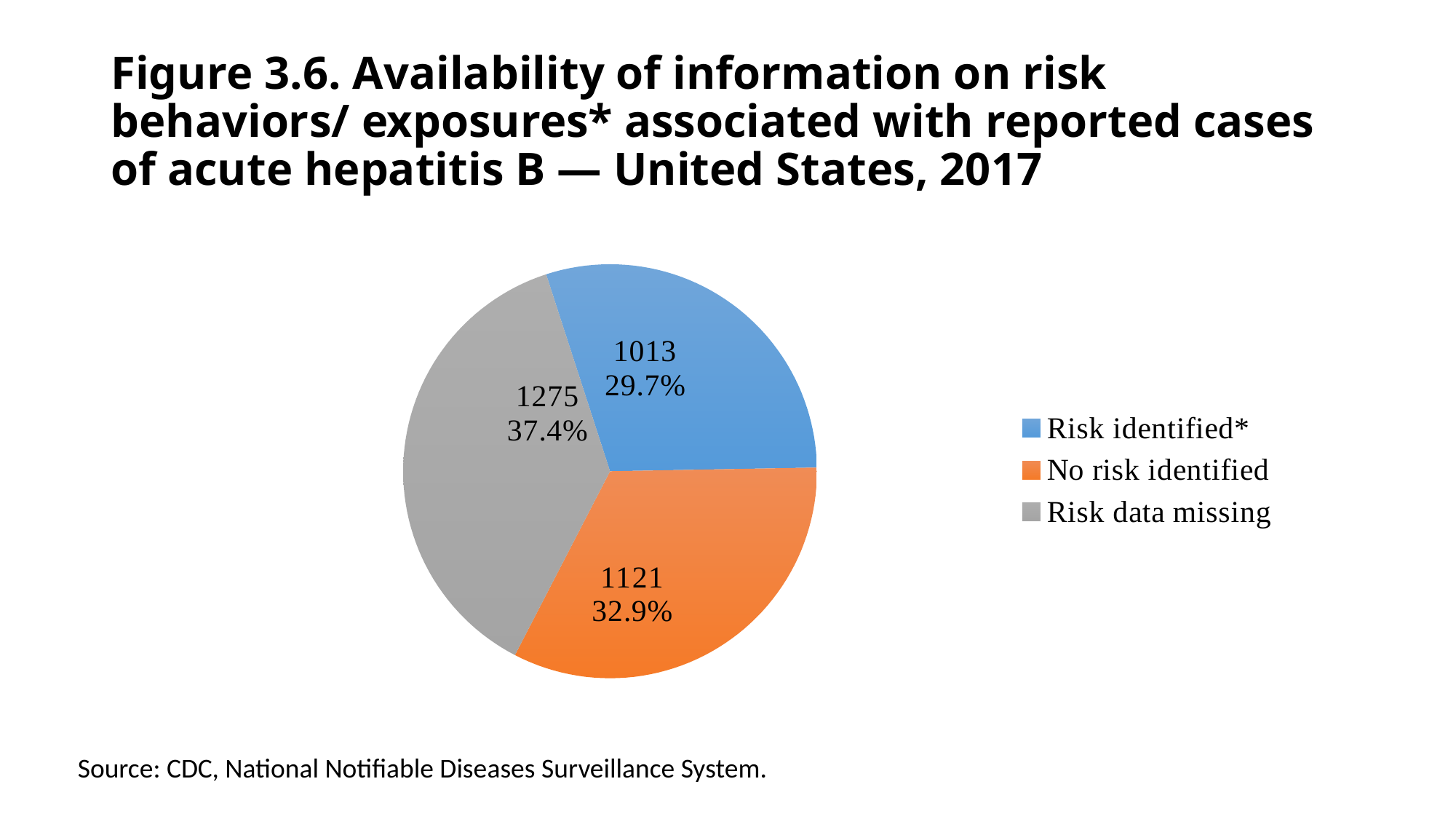
What share of the pie does 'Risk identified*' represent? 29.7% How many slices does the pie chart have? 3 How many cases are in the 'No risk identified' slice? 1121 What share of the pie does 'Risk data missing' represent? 37.4% How many cases are in the 'Risk identified*' slice? 1013 What colour is the 'No risk identified' slice? orange How many cases are in the 'Risk data missing' slice? 1275 What type of chart is shown on the slide? pie chart Which category has the smallest slice? Risk identified* Which has more cases, 'No risk identified' or 'Risk identified*'? No risk identified What is the difference in cases between 'Risk data missing' and 'Risk identified*'? 262 Which category has the largest slice? Risk data missing